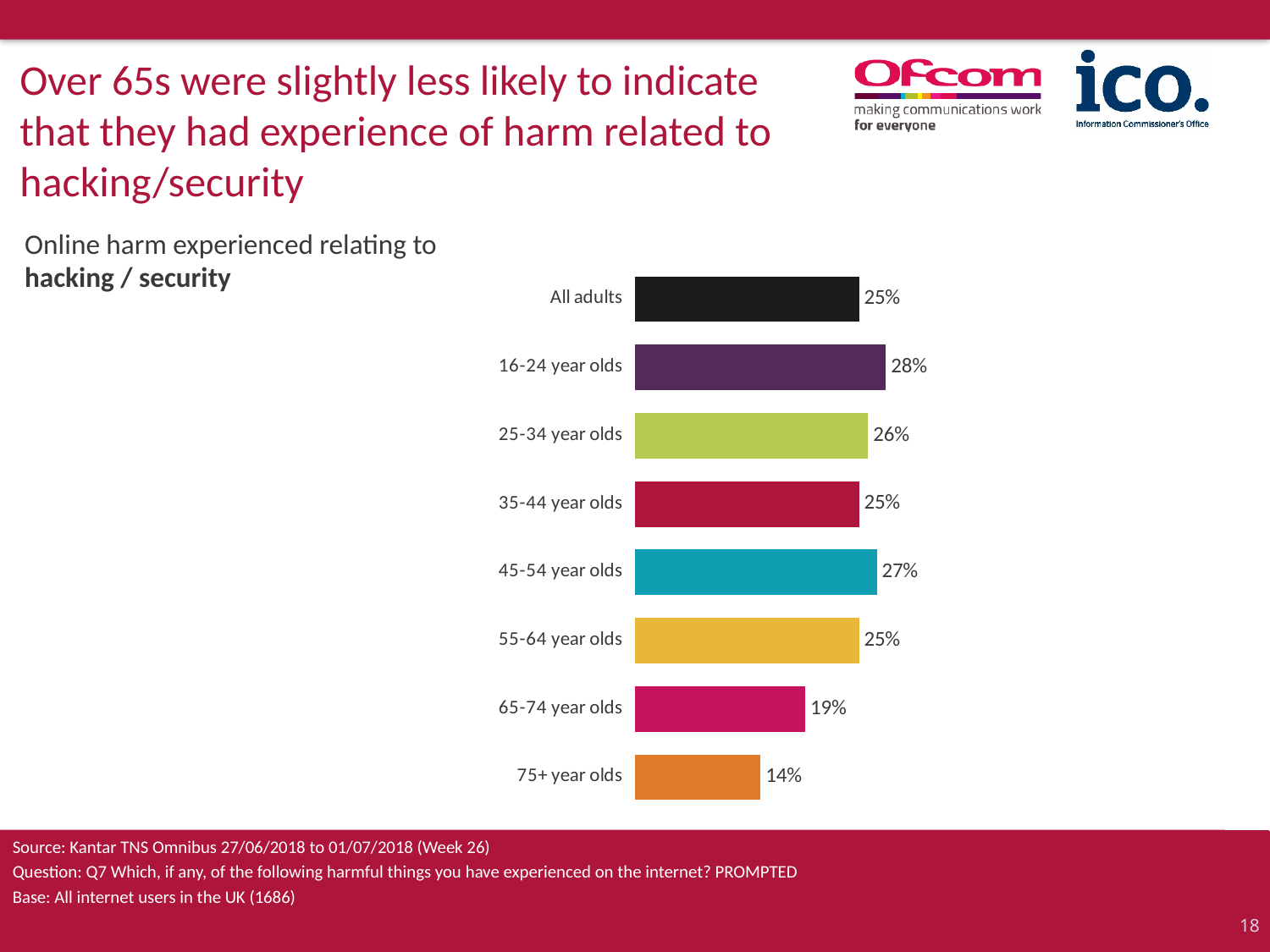
How many categories are shown in the chart? 8 What is the difference between the values for 16-24 year olds and 75+ year olds? 14% What is the value for 65-74 year olds? 19% Which age group has the lowest value? 75+ year olds Which is larger, the value for 25-34 year olds or the value for 35-44 year olds? 25-34 year olds Which age group has the highest value? 16-24 year olds What colour is the bar for 45-54 year olds? Teal What is the difference between the values for 45-54 year olds and 65-74 year olds? 8% What is the value for 16-24 year olds? 28% What percentage of all adults experienced online harm relating to hacking / security? 25% What is the value for 75+ year olds? 14% What type of chart is shown on the slide? Bar chart